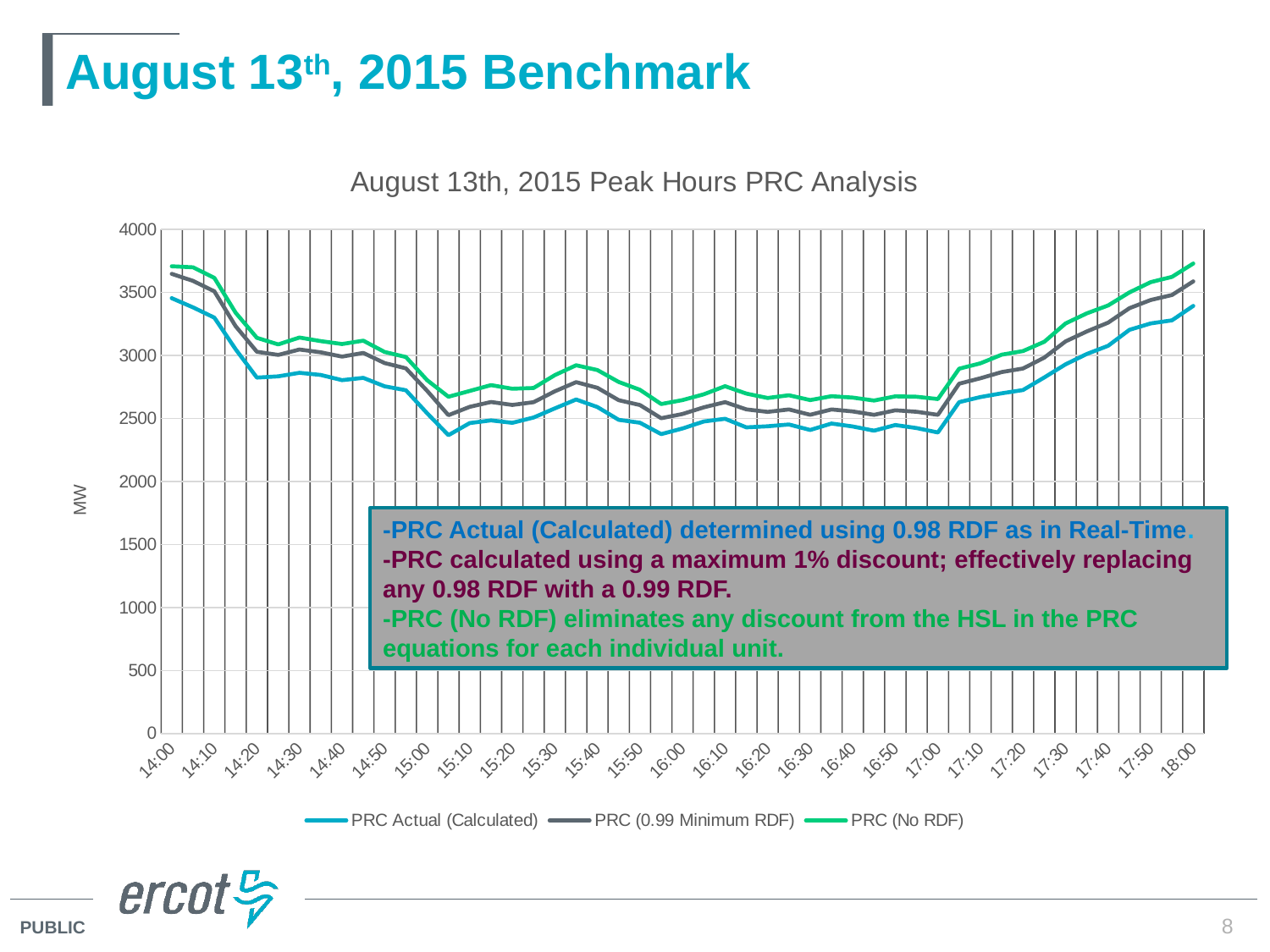
What is the title of the chart? August 13th, 2015 Peak Hours PRC Analysis Is the value for PRC Actual (Calculated) at 14:00 greater or less than 3000? greater How many time labels are shown along the x axis? 25 What kind of chart is shown on the slide? line chart What is the label on the y axis of the chart? MW Is the value for PRC (No RDF) at 16:00 greater or less than 2500? greater Is the value for PRC (No RDF) at 14:00 greater or less than 3500? greater Does the PRC Actual (Calculated) line rise or fall from 14:00 to 15:10? fall At 14:00, which is larger: PRC (No RDF) or PRC Actual (Calculated)? PRC (No RDF) How many series does the legend list? 3